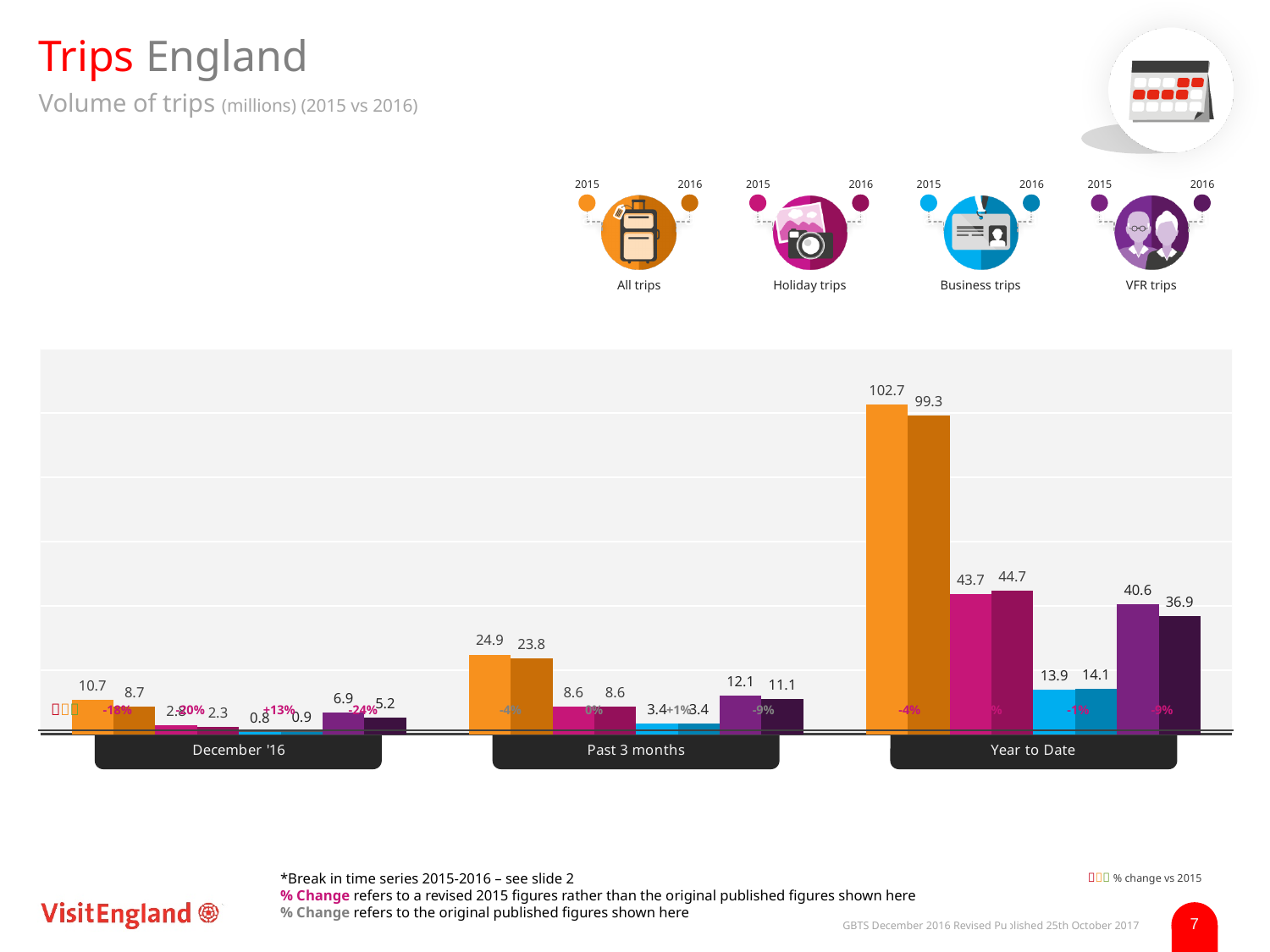
Which is larger for Year to Date: Holiday trips in 2015 or VFR trips in 2015? Holiday trips in 2015 How many period groups are shown on the x axis of the chart? 3 Which period has the highest value for All trips in 2015? Year to Date What kind of chart is shown on the slide? Bar chart What is the value for VFR trips in 2016 for December '16? 5.2 What is the difference between All trips in 2015 and 2016 for Year to Date? 3.4 Which trip type has the lowest value in 2015 for December '16? Business trips What is the difference between VFR trips in 2015 and 2016 for Past 3 months? 1.0 What is the value for Holiday trips in 2016 for Year to Date? 44.7 What is the value for Business trips in 2015 for Past 3 months? 3.4 What is the value for All trips in 2015 for Year to Date? 102.7 What is the value for All trips in 2016 for Year to Date? 99.3